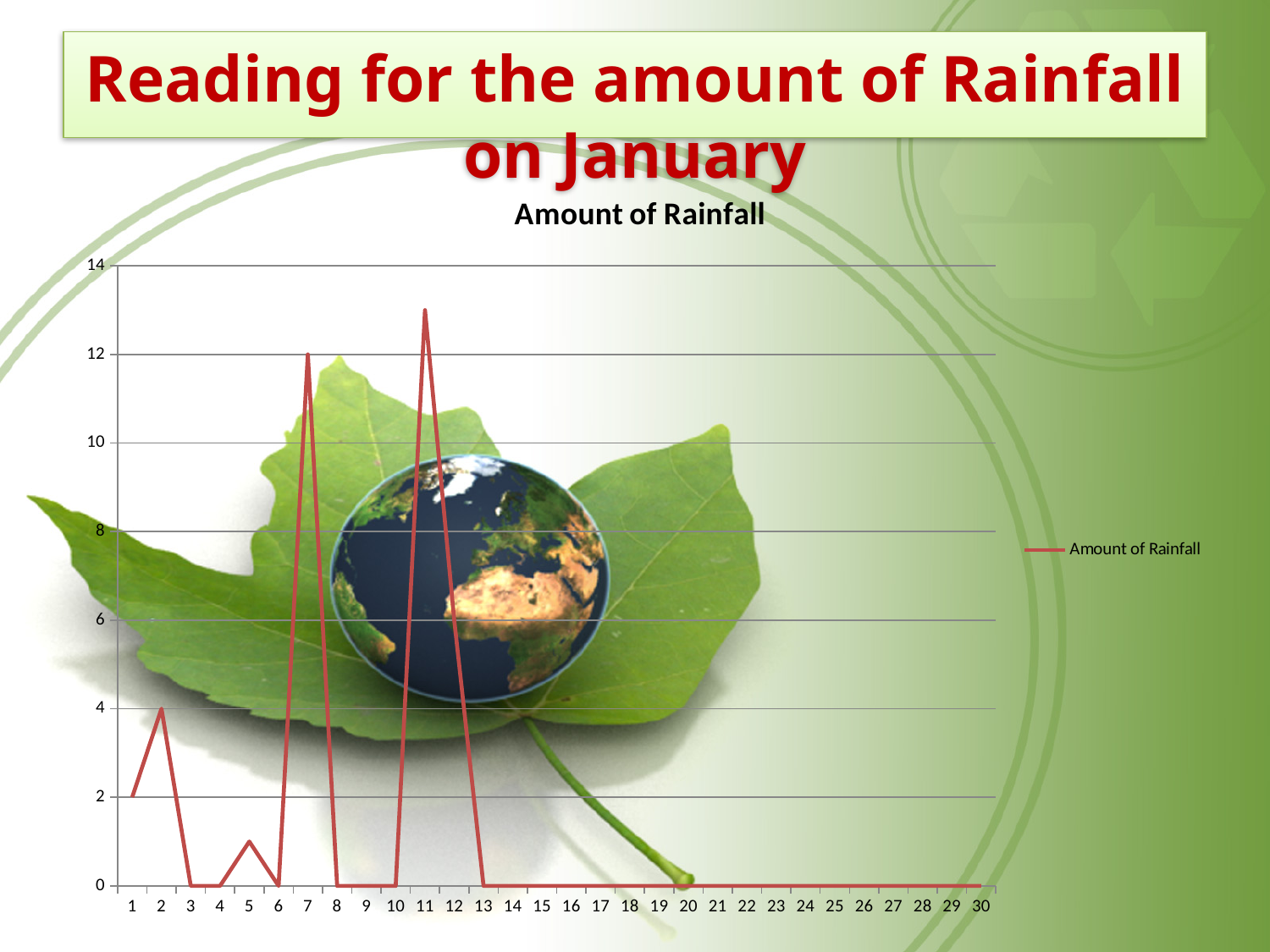
What is the title of the chart? Amount of Rainfall On which day is the amount of rainfall highest? 11 How many series does the legend list? 1 How many days are plotted along the x axis? 30 Is the amount of rainfall on day 11 greater or less than 12? greater What kind of chart is shown on the slide? line chart Which day has more rainfall, day 7 or day 11? 11 What is the amount of rainfall on day 20? 0 Is the amount of rainfall on day 5 greater or less than 2? less What is the amount of rainfall on day 2? 4 What is the amount of rainfall on day 1? 2 What is the amount of rainfall on day 7? 12